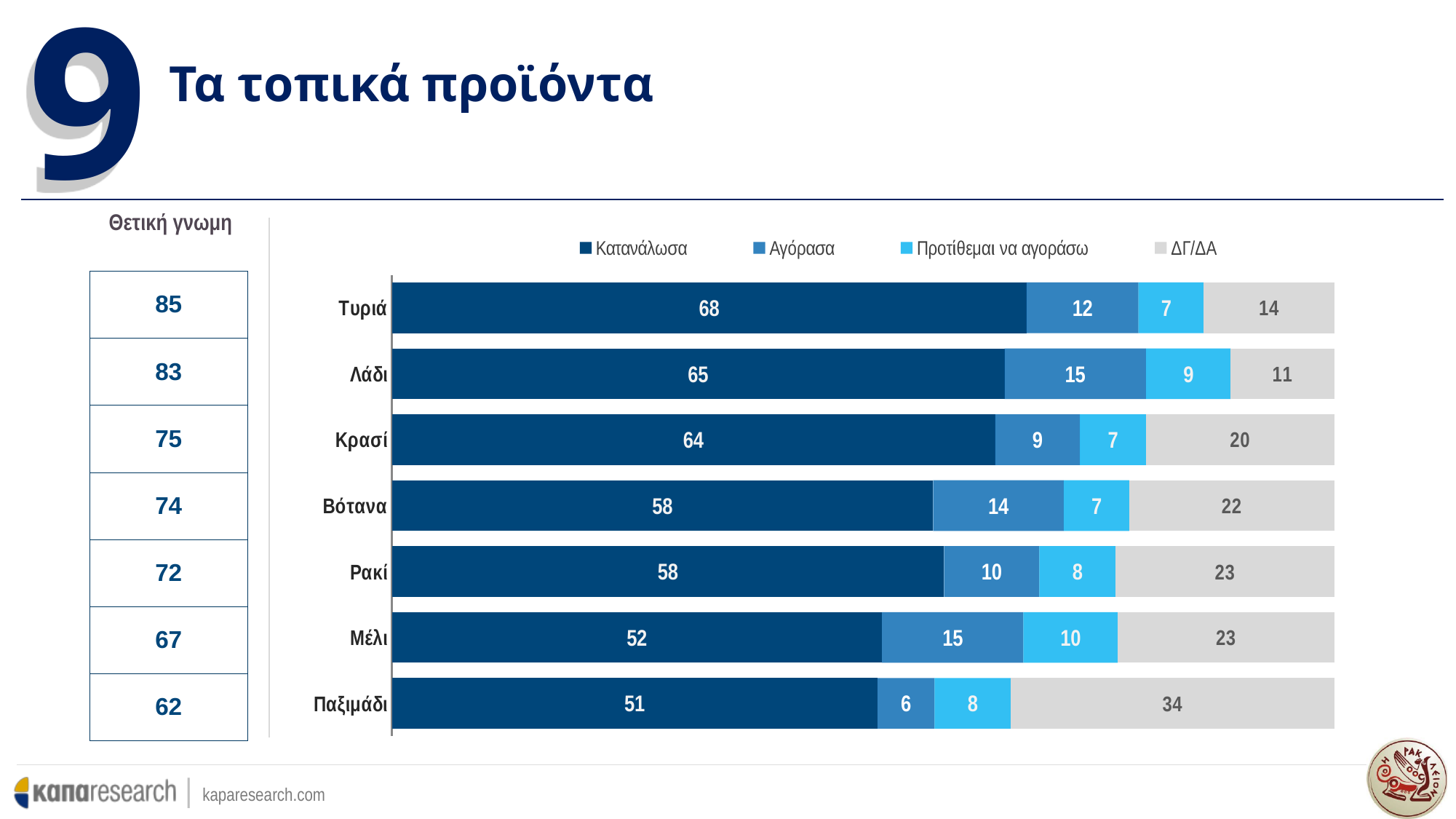
How many series does the legend list? 4 What is the value of Κατανάλωσα for Λάδι? 65 What is the value of Προτίθεμαι να αγοράσω for Μέλι? 10 Which category has the highest ΔΓ/ΔΑ value? Παξιμάδι What is the difference between the Κατανάλωσα values for Τυριά and Παξιμάδι? 17 What is the ΔΓ/ΔΑ value for Παξιμάδι? 34 What is the total of the stacked bar for Κρασί? 100 Which category has the lowest Κατανάλωσα value? Παξιμάδι Which has a larger Αγόρασα value, Λάδι or Κρασί? Λάδι Which category has the highest Κατανάλωσα value? Τυριά How many categories are shown in the chart? 7 What kind of chart is shown on the slide? Stacked bar chart